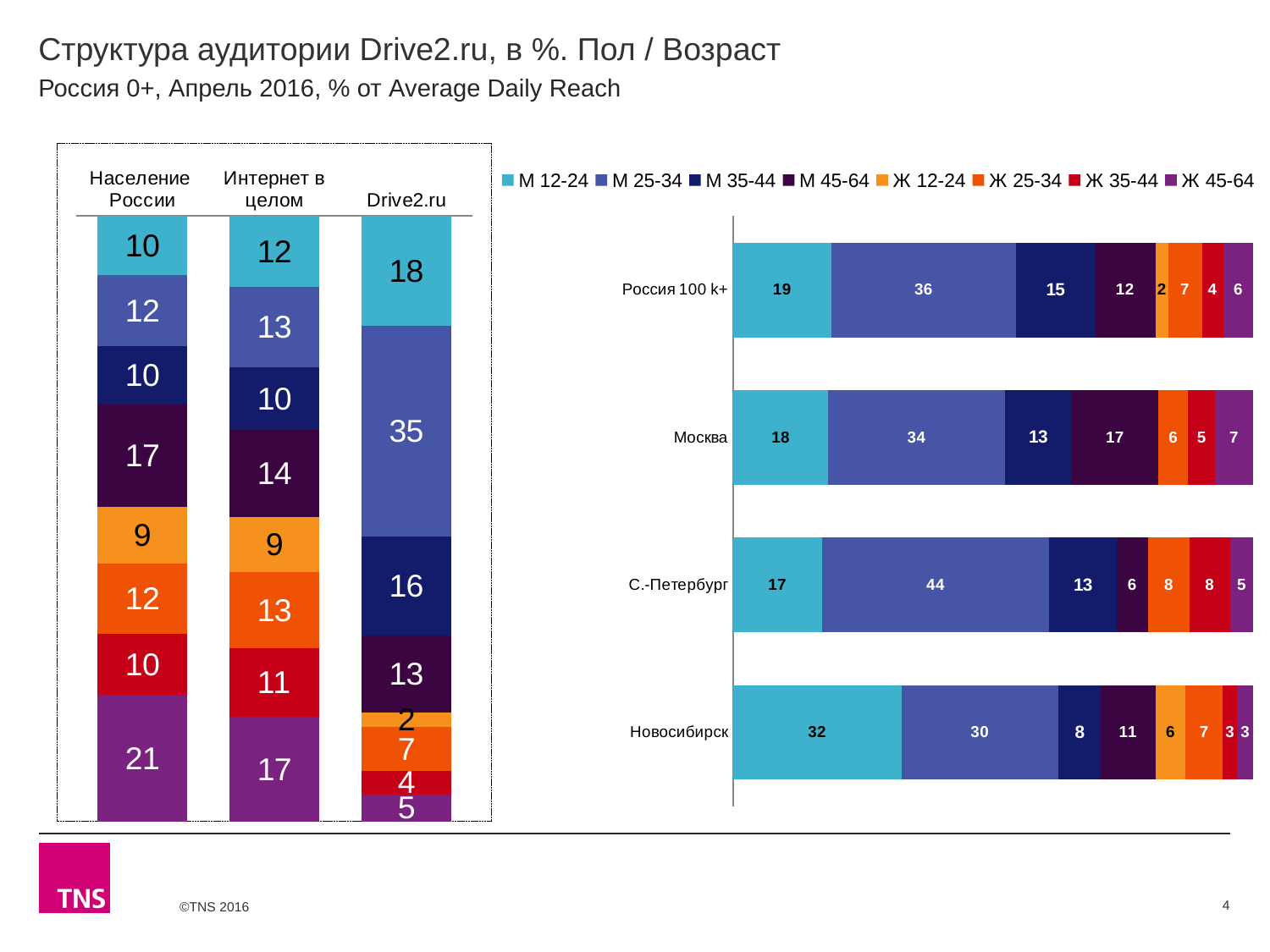
On the left chart, which segment is the largest in the Drive2.ru bar? М 25-34 On the right chart, which city has the highest М 12-24 value? Новосибирск How many series does the legend list? 8 On the left chart, what is the value of the М 25-34 segment for Drive2.ru? 35 On the left chart, what is the value of the М 45-64 segment for Интернет в целом? 14 On the right chart, what is the value of the М 12-24 segment for Новосибирск? 32 On the right chart, which is larger: the М 45-64 value for Москва or for С.-Петербург? Москва On the right chart, what is the value of the М 25-34 segment for С.-Петербург? 44 What kind of chart is the right chart? Stacked bar chart On the left chart, which segment is the smallest in the Drive2.ru bar? Ж 12-24 On the left chart, what is the difference between the М 25-34 values for Drive2.ru and Интернет в целом? 22 On the left chart, what is the value of the Ж 45-64 segment for Население России? 21